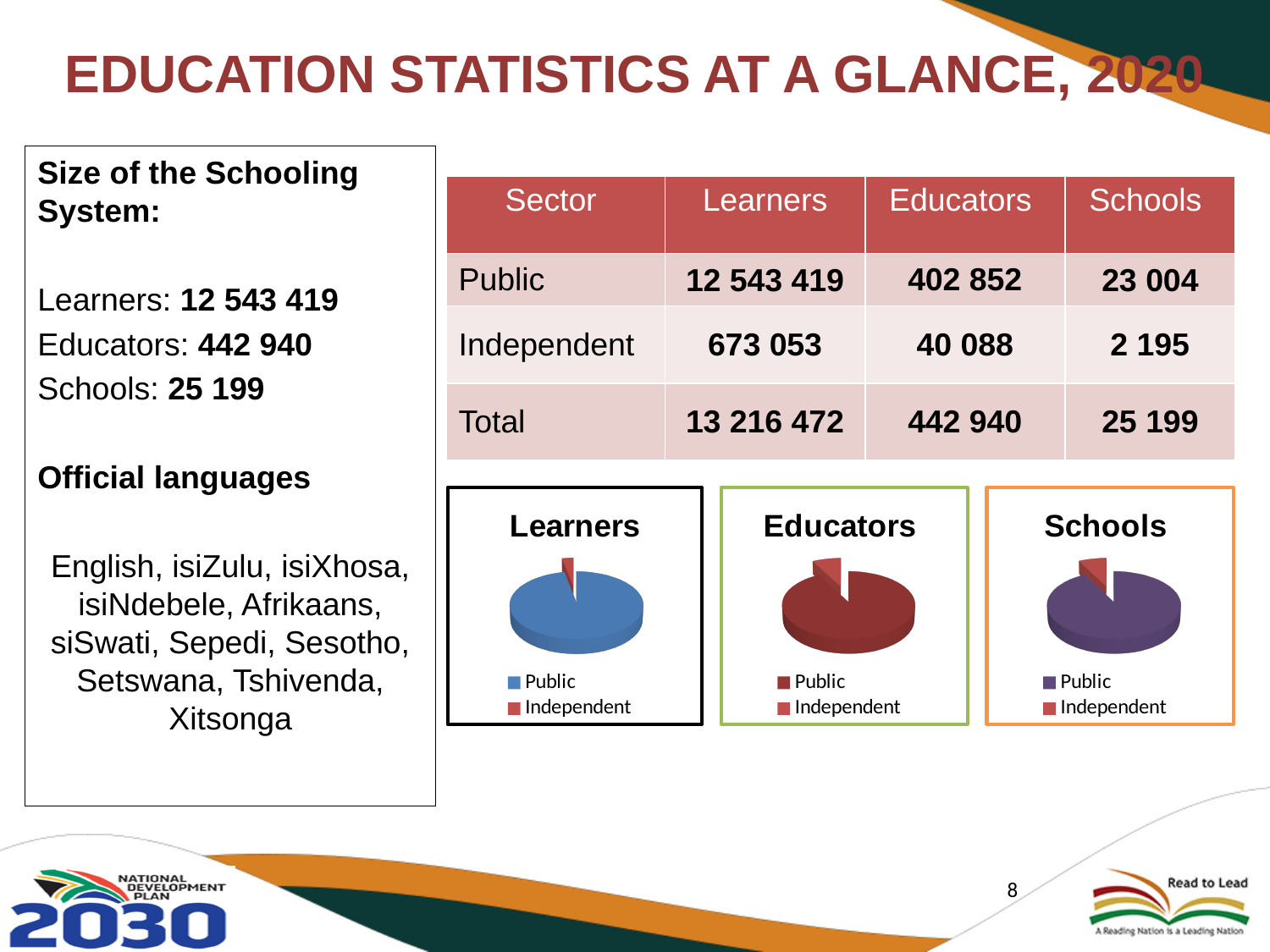
In the Schools pie chart, which slice is larger, Public or Independent? Public How many entries does the legend of the Learners pie chart list? 2 In the Learners pie chart, which sector has the largest slice? Public What kind of chart is the Learners chart? Pie chart In the Educators pie chart, which sector has the smallest slice? Independent What are the two legend entries in the Schools pie chart? Public, Independent In the Schools pie chart, which sector has the largest slice? Public What kind of chart is the Schools chart? Pie chart How many slices does the Educators pie chart have? 2 How many pie charts are shown on the slide? 3 In the Learners pie chart, which sector has the smallest slice? Independent What is the title of the pie chart on the far right of the slide? Schools